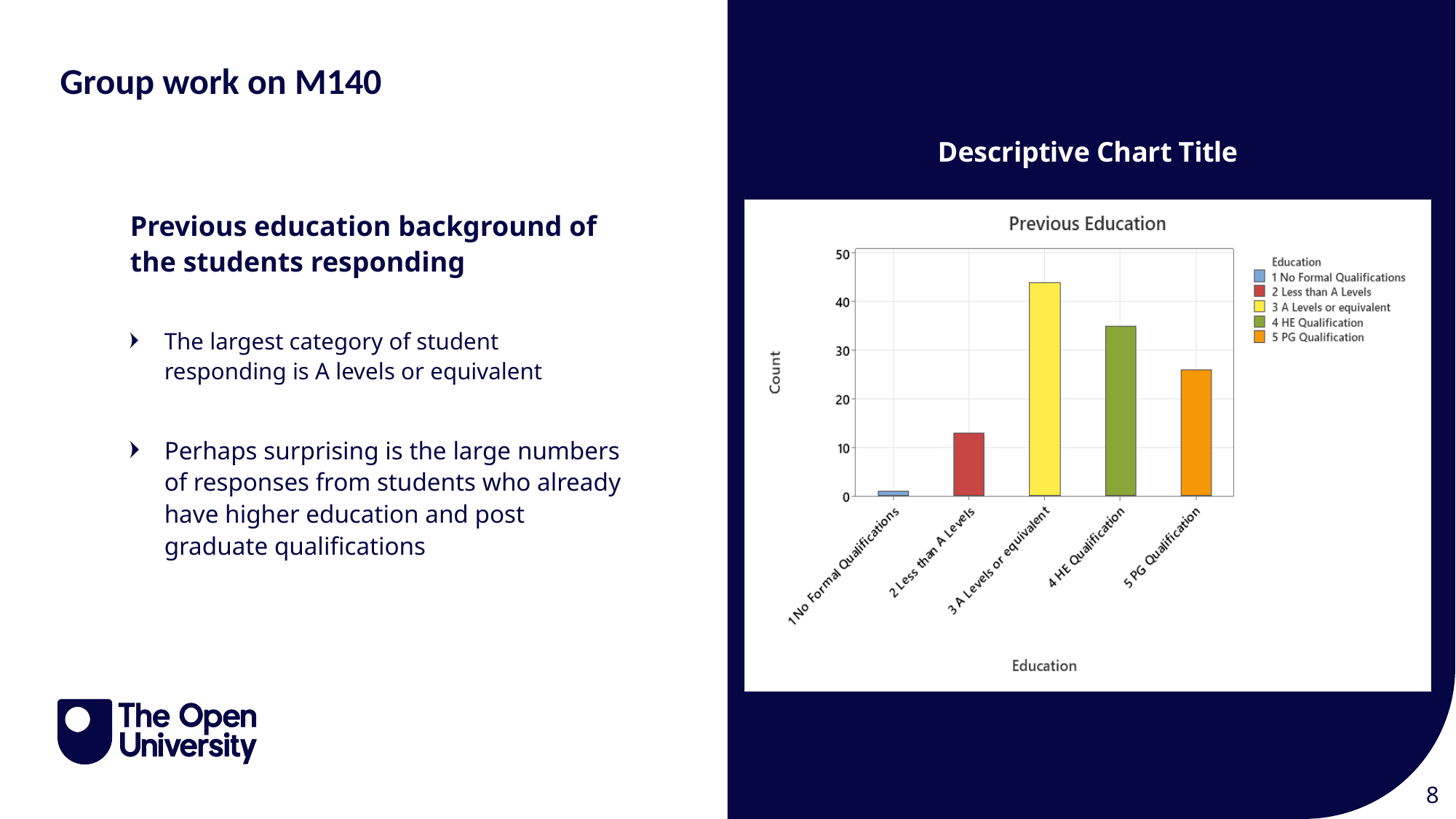
What is the label on the y axis of the Previous Education chart? Count How many entries does the legend of the Previous Education chart list? 5 Which category has the highest count in the Previous Education chart? 3 A Levels or equivalent Is the count for 4 HE Qualification greater or less than 30? greater How many categories are shown on the x axis of the Previous Education chart? 5 Is the count for 5 PG Qualification greater or less than 30? less Is the count for 3 A Levels or equivalent greater or less than 40? greater What colour is the bar for 3 A Levels or equivalent in the Previous Education chart? yellow What kind of chart is shown under the title "Previous Education"? bar chart Which category has the lowest count in the Previous Education chart? 1 No Formal Qualifications Which has a larger count, 4 HE Qualification or 5 PG Qualification? 4 HE Qualification